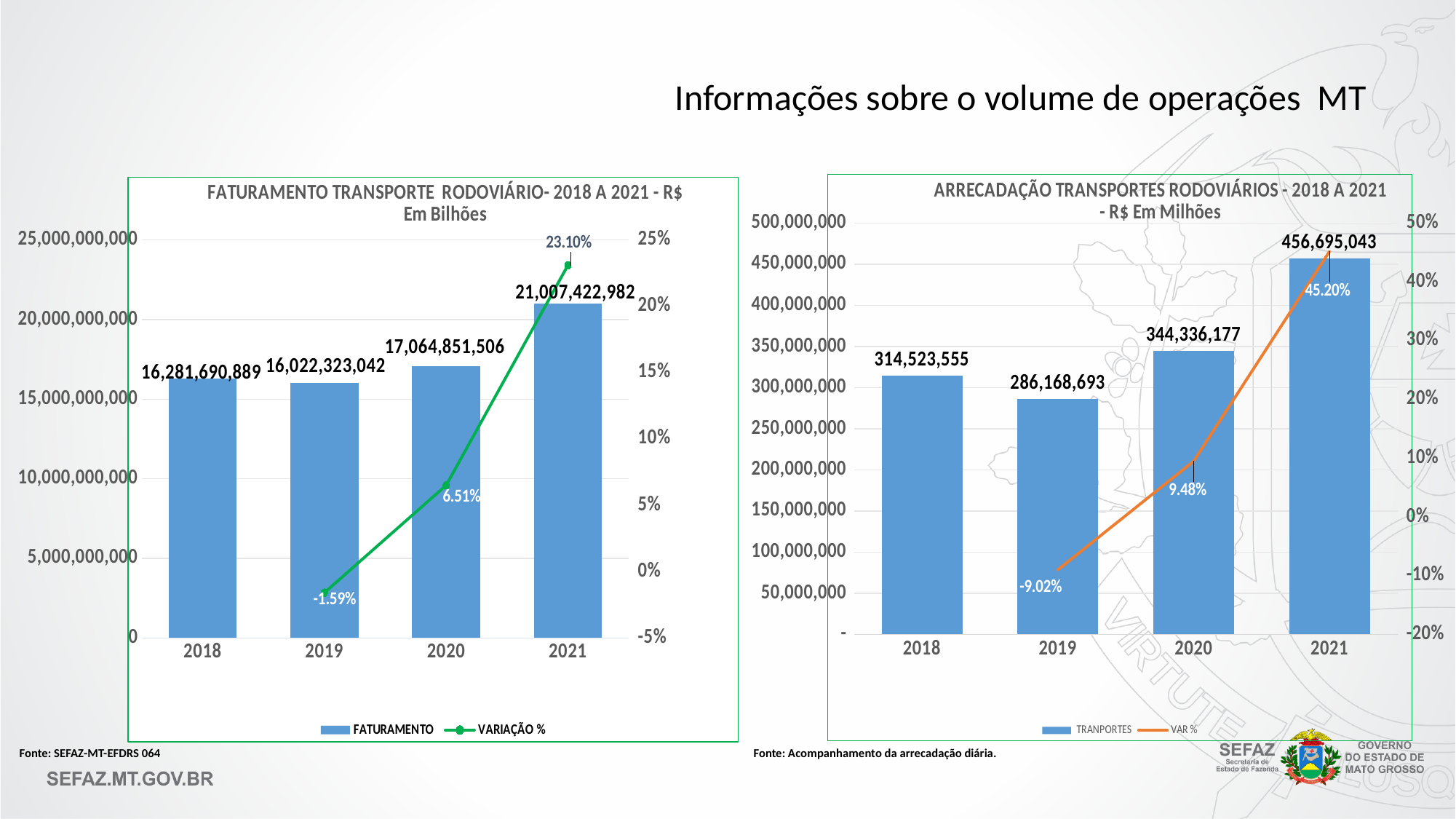
In the ARRECADAÇÃO TRANSPORTES RODOVIÁRIOS chart, what is the TRANPORTES value for 2019? 286,168,693 In the ARRECADAÇÃO TRANSPORTES RODOVIÁRIOS chart, what is the VAR % value for 2021? 45.20% In the ARRECADAÇÃO TRANSPORTES RODOVIÁRIOS chart, is the TRANPORTES value for 2018 larger or smaller than the value for 2019? larger In the FATURAMENTO TRANSPORTE RODOVIÁRIO chart, how many series does the legend list? 2 In the ARRECADAÇÃO TRANSPORTES RODOVIÁRIOS chart, which year has the highest TRANPORTES value? 2021 In the ARRECADAÇÃO TRANSPORTES RODOVIÁRIOS chart, what is the difference between the TRANPORTES values for 2021 and 2020? 112,358,866 In the ARRECADAÇÃO TRANSPORTES RODOVIÁRIOS chart, what colour is the VAR % line? Orange In the FATURAMENTO TRANSPORTE RODOVIÁRIO chart, which year has the lowest FATURAMENTO? 2019 In the FATURAMENTO TRANSPORTE RODOVIÁRIO chart, what is the VARIAÇÃO % value for 2019? -1.59% In the FATURAMENTO TRANSPORTE RODOVIÁRIO chart, what is the FATURAMENTO value for 2021? 21,007,422,982 In the FATURAMENTO TRANSPORTE RODOVIÁRIO chart, what is the difference between the FATURAMENTO values for 2021 and 2020? 3,942,571,476 In the ARRECADAÇÃO TRANSPORTES RODOVIÁRIOS chart, how many years are shown on the x axis? 4